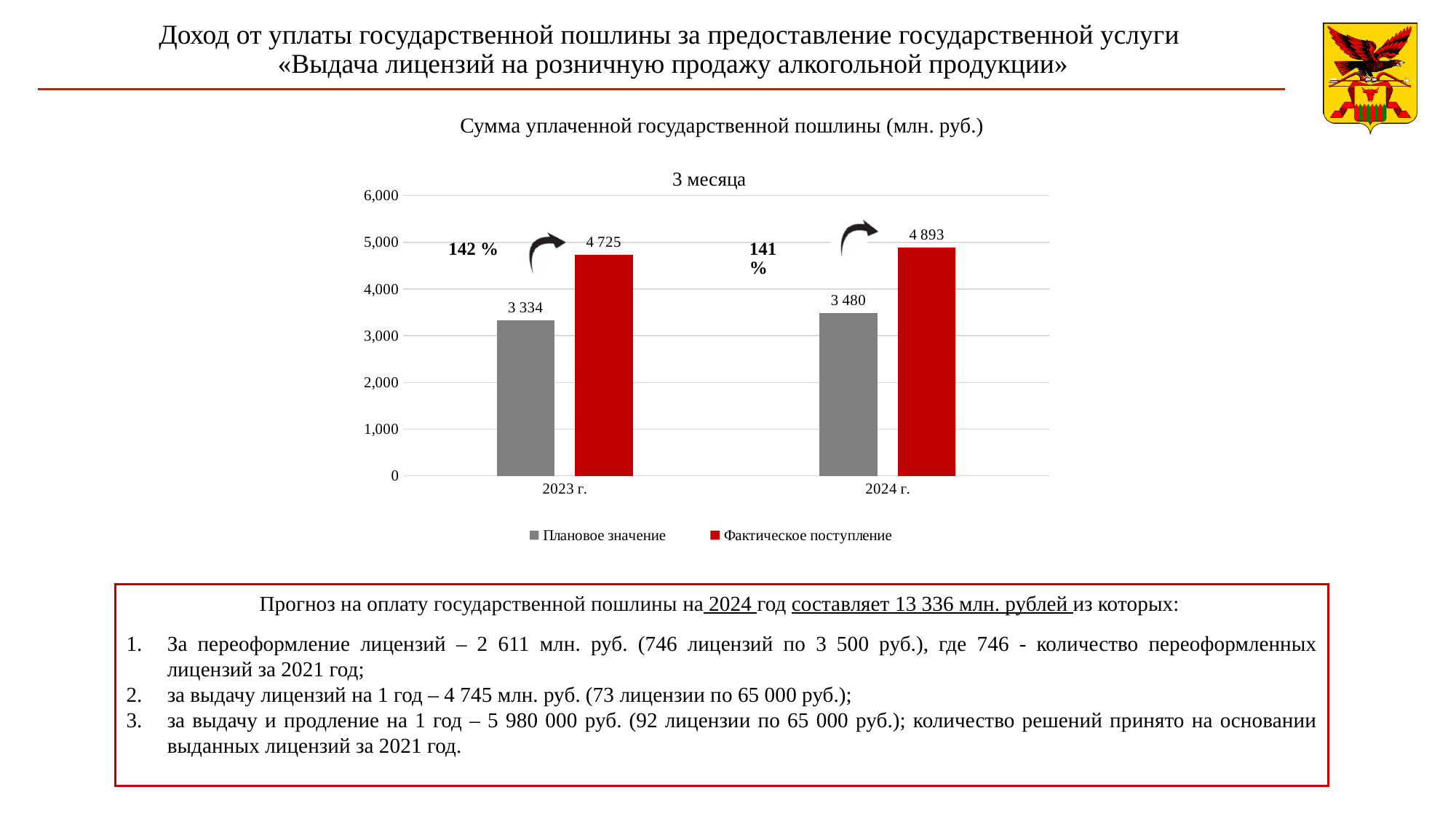
What is the title of the chart? 3 месяца What is the difference between «Фактическое поступление» and «Плановое значение» for 2023 г.? 1 391 How many series does the chart legend list? 2 What is the difference between «Фактическое поступление» for 2024 г. and for 2023 г.? 168 Which bar in the chart has the lowest value? Плановое значение, 2023 г. What is the value of «Фактическое поступление» for 2023 г.? 4 725 What is the value of «Плановое значение» for 2024 г.? 3 480 What is the value of «Фактическое поступление» for 2024 г.? 4 893 Which bar in the chart has the highest value? Фактическое поступление, 2024 г. Which is larger: «Плановое значение» for 2024 г. or «Фактическое поступление» for 2023 г.? Фактическое поступление for 2023 г. What is the value of «Плановое значение» for 2023 г.? 3 334 What kind of chart is shown on the slide? Bar chart